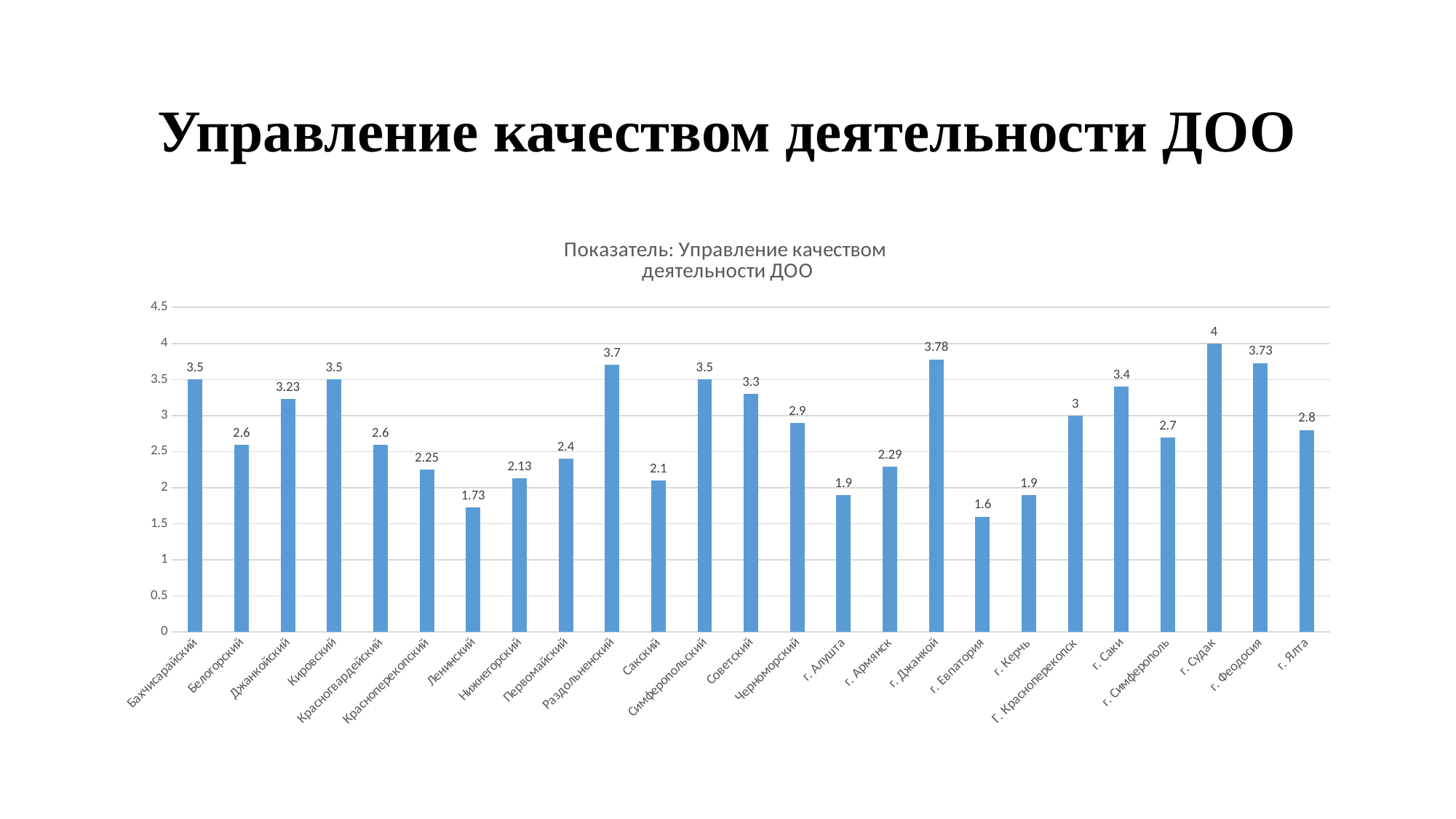
Which category has the lowest value? г. Евпатория What is the value for Ленинский? 1.73 Which category has the highest value? г. Судак What is the value for г. Феодосия? 3.73 What is the value for г. Евпатория? 1.6 What kind of chart is shown on the slide? bar chart What is the value for Раздольненский? 3.7 How many categories are shown on the x axis? 25 What is the title of the chart? Показатель: Управление качеством деятельности ДОО What is the difference between the values for г. Джанкой and г. Алушта? 1.88 Which is larger, the value for Советский or the value for Черноморский? Советский Is the value for г. Саки greater or less than 3? greater